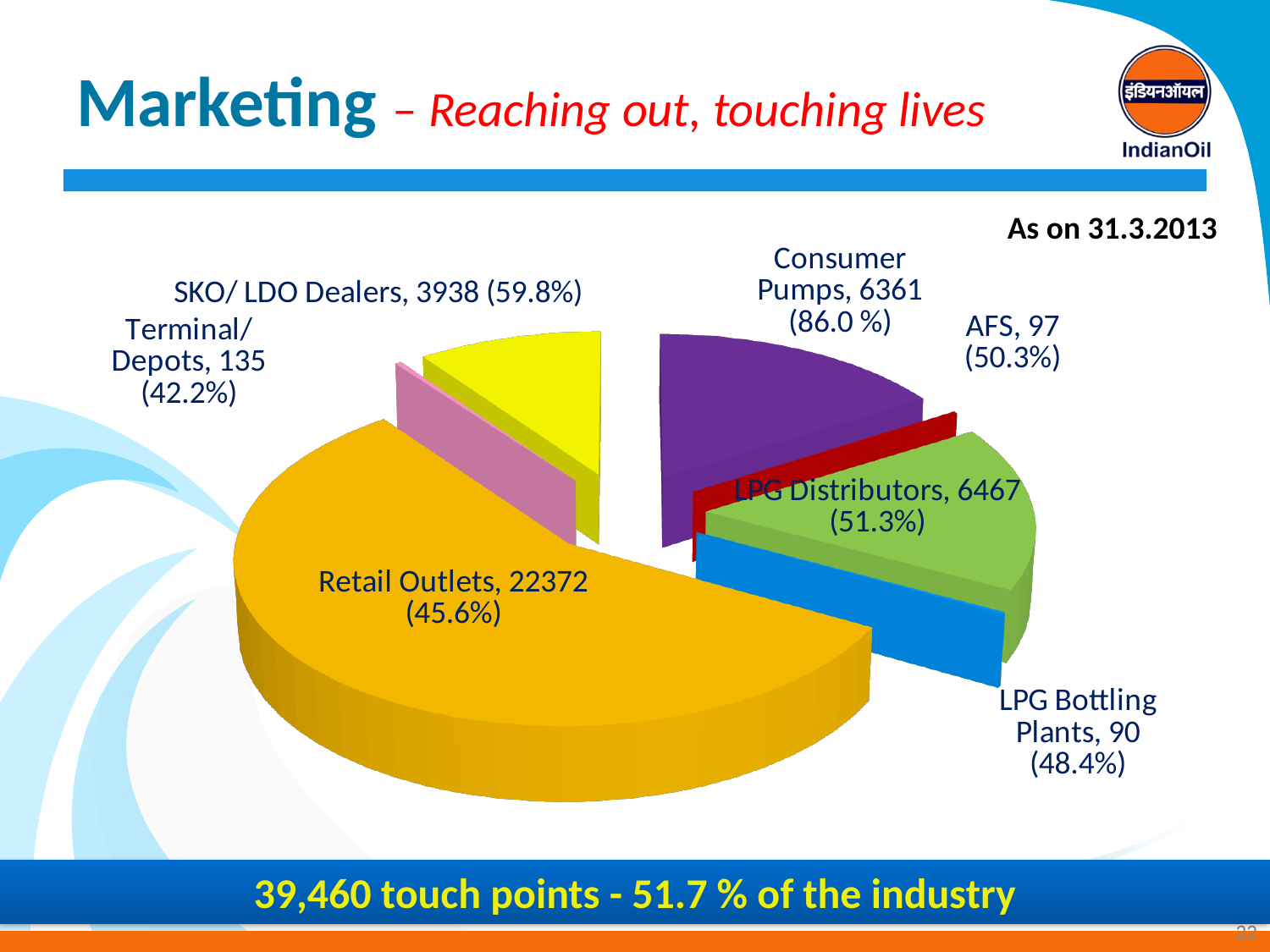
What is the value shown for LPG Distributors? 6467 Which category has the largest slice of the pie? Retail Outlets Which is larger, the value for Consumer Pumps or the value for SKO/LDO Dealers? Consumer Pumps As of what date is the data in the chart reported? 31.3.2013 What is the total of all the slice values in the pie chart? 39,460 What kind of chart is shown on the slide? pie chart Which category has the smallest value in the pie chart? LPG Bottling Plants What is the difference between the values for Terminal/Depots and AFS? 38 How many slices does the pie chart have? 7 What percentage is printed in parentheses next to Consumer Pumps? 86.0 % What is the value shown for Retail Outlets? 22372 What is the difference between the values for LPG Distributors and Consumer Pumps? 106